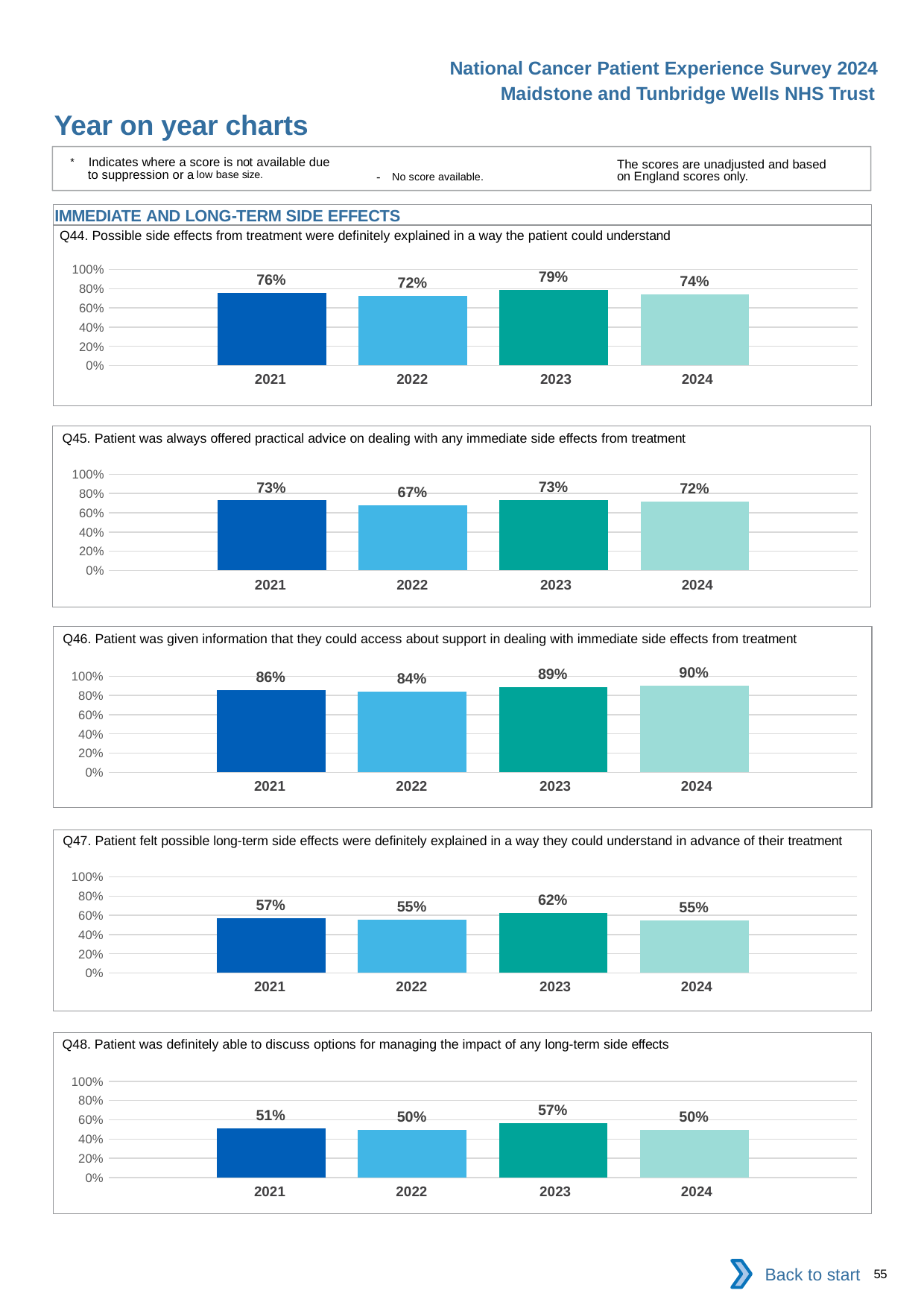
In the Q45 chart, what is the value for 2024? 72% In the Q45 chart, which year has the lowest value? 2022 In the Q47 chart, what is the difference between the 2023 and 2022 values? 7% In the Q46 chart, what is the difference between the 2024 and 2021 values? 4% What type of chart is used for Q45? bar chart What is the section heading above the Q44 chart? IMMEDIATE AND LONG-TERM SIDE EFFECTS In the Q48 chart, is the value for 2023 greater or less than 60%? less In the Q48 chart, what is the value for 2021? 51% How many bars are shown in the Q46 chart? 4 In the Q44 chart, what is the value for 2023? 79% In the Q44 chart, is the value for 2022 larger or smaller than the value for 2024? smaller In the Q47 chart, which year has the highest value? 2023